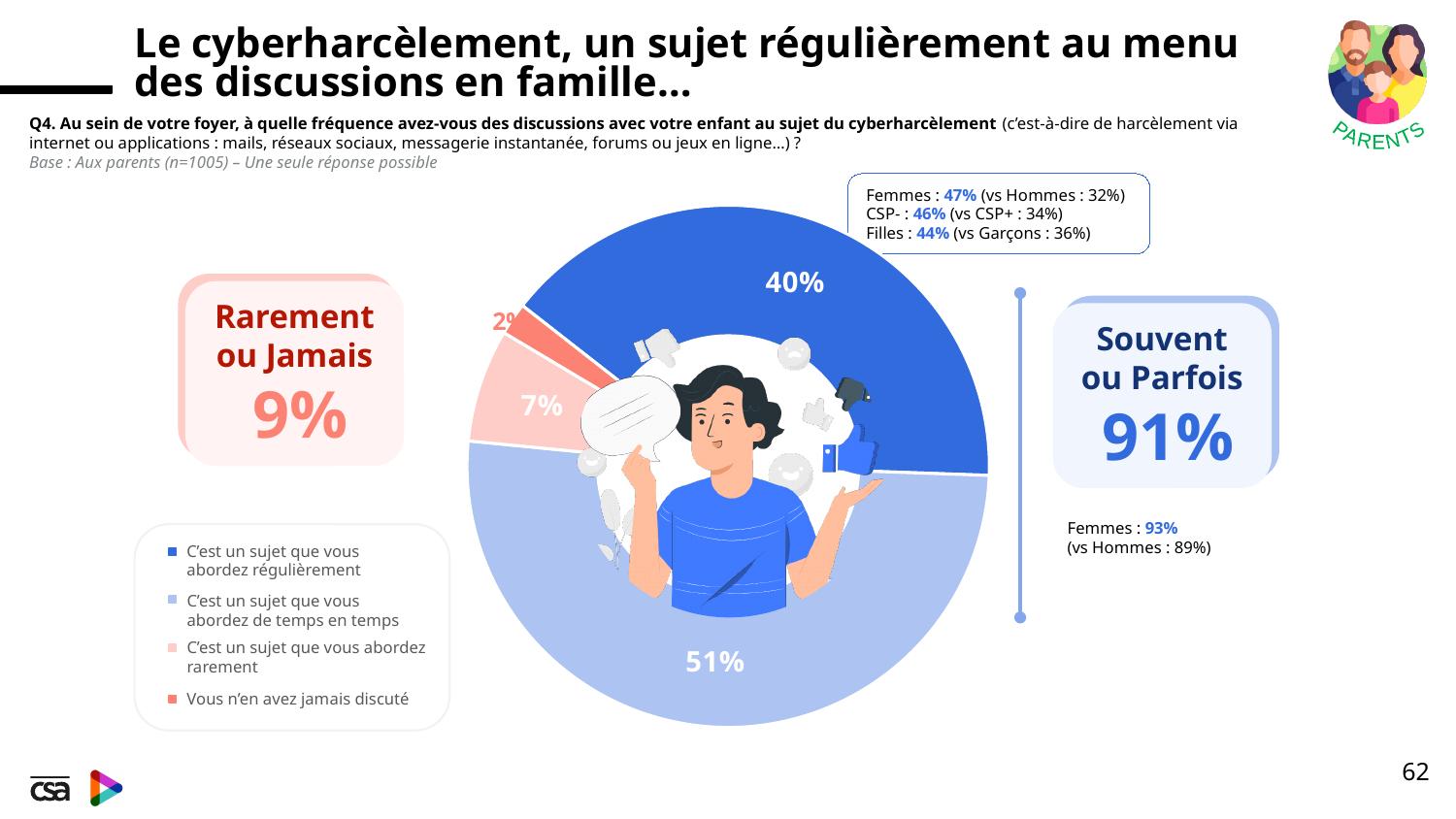
What combined percentage is shown in the "Souvent ou Parfois" callout? 91% What colour is the slice for "C'est un sujet que vous abordez régulièrement"? Dark blue What percentage of parents say cyberbullying is a subject they discuss regularly ("C'est un sujet que vous abordez régulièrement")? 40% Which response has the largest share of the pie? C'est un sujet que vous abordez de temps en temps What kind of chart is shown on the slide? Doughnut chart Which is larger: the share for "abordez régulièrement" or the share for "abordez rarement"? C'est un sujet que vous abordez régulièrement Which response has the smallest share of the pie? Vous n'en avez jamais discuté What is the difference in percentage points between "de temps en temps" (51%) and "régulièrement" (40%)? 11 percentage points How many response categories does the pie chart contain? 4 What percentage corresponds to "C'est un sujet que vous abordez rarement"? 7% What percentage corresponds to "C'est un sujet que vous abordez de temps en temps"? 51% What combined percentage is shown in the "Rarement ou Jamais" callout? 9%